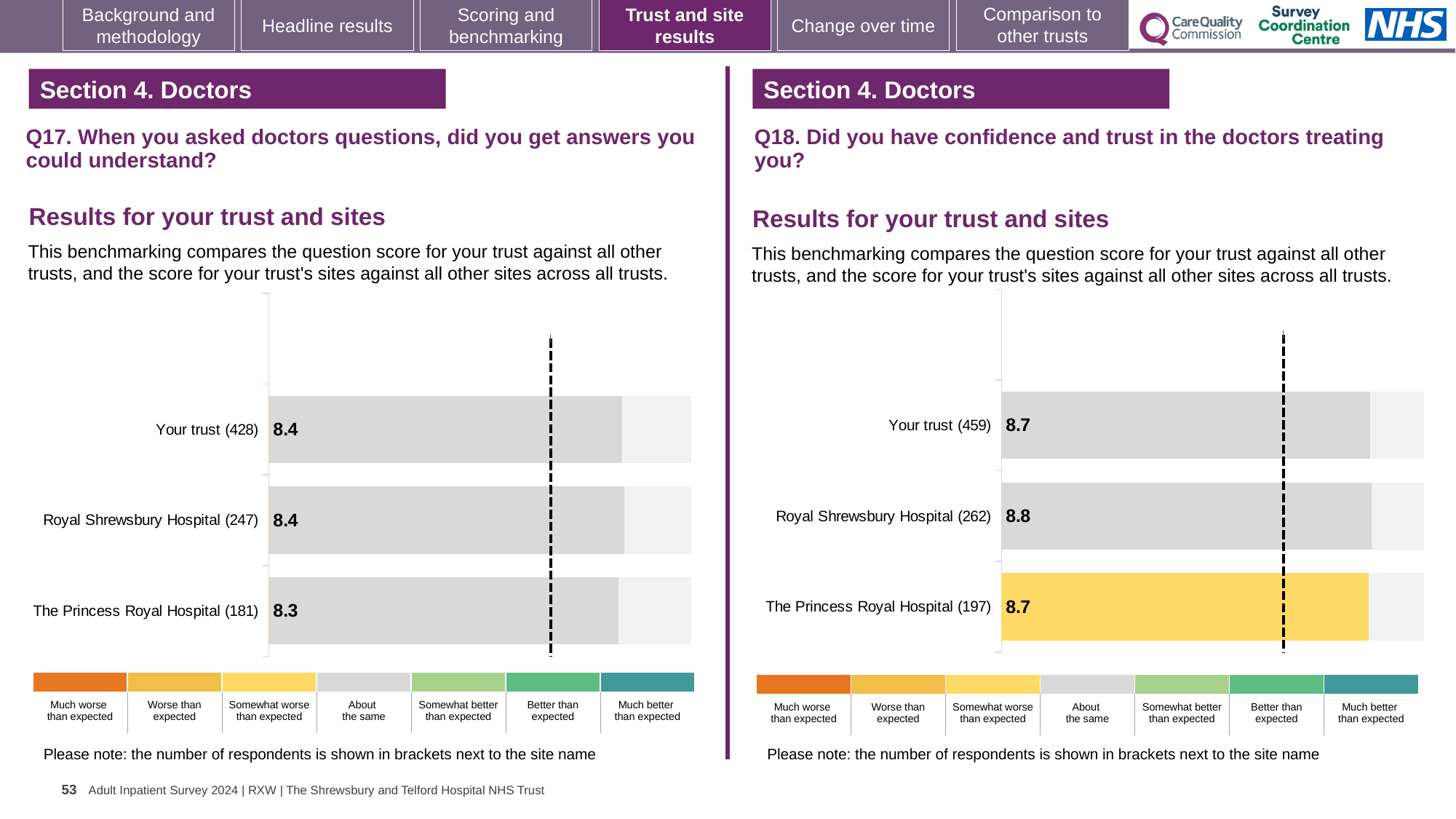
On the Q17 chart (left), what is the score for The Princess Royal Hospital? 8.3 On the Q17 chart (left), how many bars are plotted? 3 On the Q18 chart (right), which bar is coloured yellow rather than grey? The Princess Royal Hospital On the Q17 chart (left), what is the difference between the scores for Your trust and The Princess Royal Hospital? 0.1 On the Q17 chart (left), what is the score for Your trust? 8.4 On the Q18 chart (right), how many respondents are shown in brackets for Your trust? 459 On the Q18 chart (right), what is the score for Royal Shrewsbury Hospital? 8.8 On the Q18 chart (right), what is the score for The Princess Royal Hospital? 8.7 On the Q17 chart (left), which site or trust has the lowest score? The Princess Royal Hospital On the Q18 chart (right), what is the difference between the scores for Royal Shrewsbury Hospital and The Princess Royal Hospital? 0.1 What kind of chart is used on the Q18 chart (right)? Bar chart On the Q18 chart (right), which site or trust has the highest score? Royal Shrewsbury Hospital